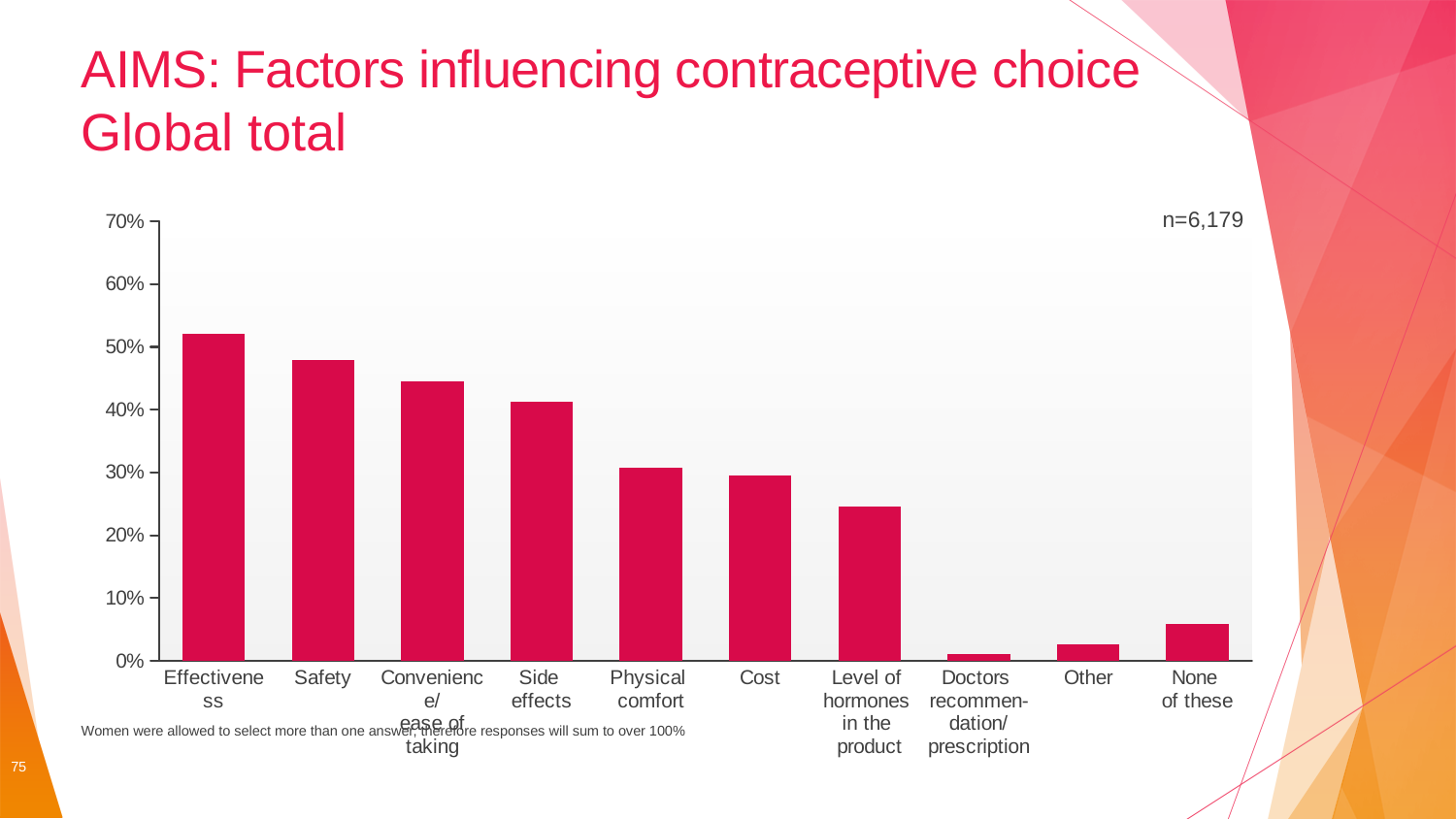
Is the value for None of these greater or less than 10%? less Which factor has the lowest value in the chart? Doctors recommendation/prescription Which is larger, the value for Other or the value for None of these? None of these How many factor categories are shown on the x axis of the chart? 10 Which factor has the highest value in the chart? Effectiveness Is the value for Effectiveness greater or less than 50%? greater Is the value for Safety greater or less than 50%? less What sample size (n) is shown on the chart? n=6,179 Which is larger, the value for Effectiveness or the value for Safety? Effectiveness What kind of chart is shown on the slide? Bar chart